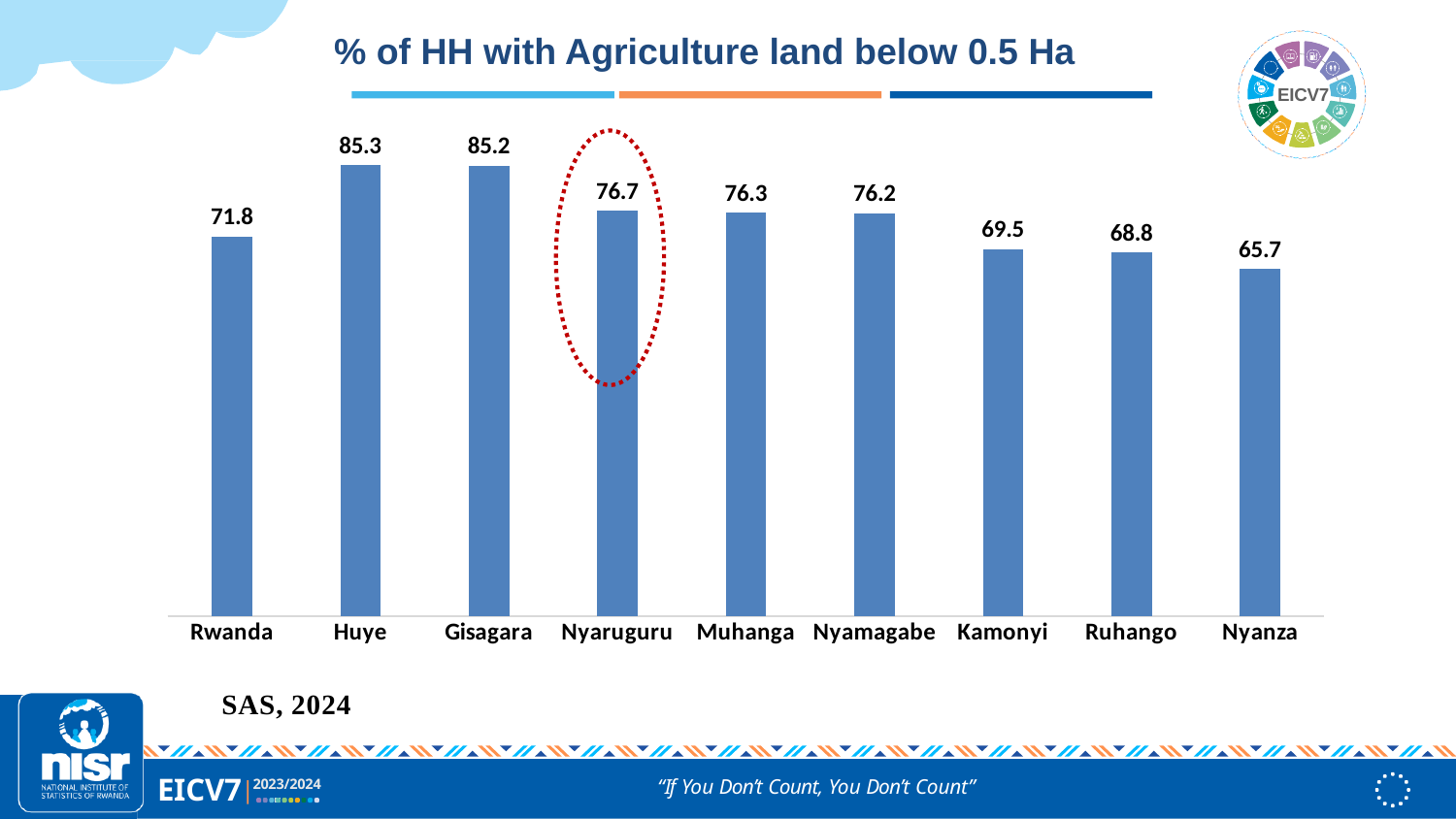
What is the difference between the values for Huye and Nyanza? 19.6 What is the title of the chart? % of HH with Agriculture land below 0.5 Ha What is the value for Nyaruguru? 76.7 Which is larger, the value for Muhanga or the value for Ruhango? Muhanga How many categories are shown on the x axis? 9 What is the difference between the values for Nyaruguru and Rwanda? 4.9 What is the value for Kamonyi? 69.5 Which is larger, the value for Gisagara or the value for Nyamagabe? Gisagara Which district has the highest value? Huye What is the value for Rwanda? 71.8 What kind of chart is shown on the slide? Bar chart Which district has the lowest value? Nyanza